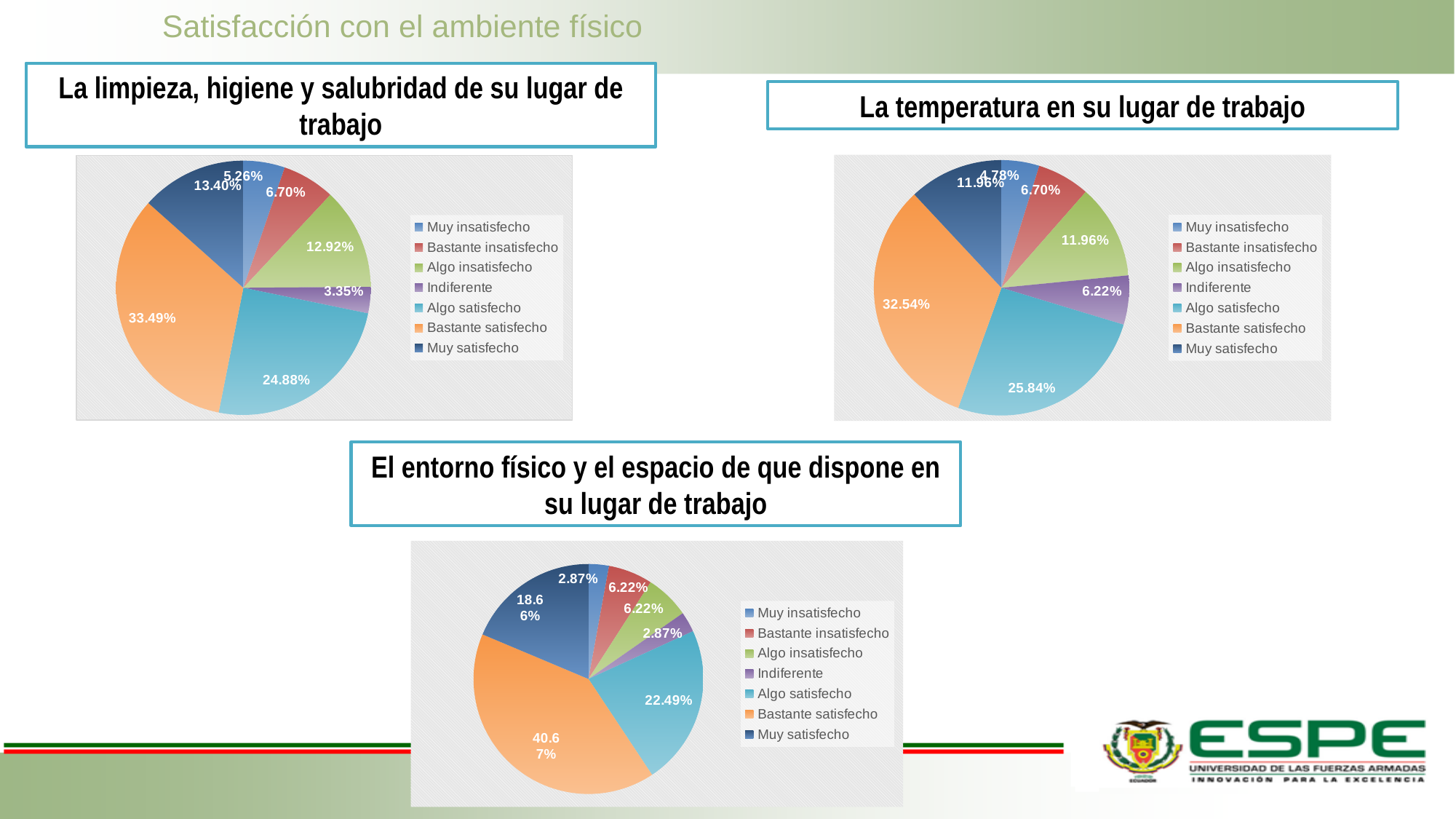
In the chart 'La temperatura en su lugar de trabajo', what percentage is shown for Algo satisfecho? 25.84% How many categories does the legend list in the chart 'El entorno físico y el espacio de que dispone en su lugar de trabajo'? 7 In the chart 'La limpieza, higiene y salubridad de su lugar de trabajo', what percentage is shown for Indiferente? 3.35% In the chart 'La limpieza, higiene y salubridad de su lugar de trabajo', which category has the smallest slice? Indiferente In the chart 'La temperatura en su lugar de trabajo', what percentage is shown for Muy insatisfecho? 4.78% What type of chart is used for 'La temperatura en su lugar de trabajo'? Pie chart In the chart 'La temperatura en su lugar de trabajo', which is larger: Indiferente or Bastante insatisfecho? Bastante insatisfecho In the chart 'La limpieza, higiene y salubridad de su lugar de trabajo', what percentage is shown for Bastante satisfecho? 33.49% In the chart 'La temperatura en su lugar de trabajo', which category has the largest slice? Bastante satisfecho In the chart 'El entorno físico y el espacio de que dispone en su lugar de trabajo', what percentage is shown for Algo satisfecho? 22.49% In the chart 'El entorno físico y el espacio de que dispone en su lugar de trabajo', what percentage is shown for Bastante satisfecho? 40.67% In the chart 'La limpieza, higiene y salubridad de su lugar de trabajo', what is the difference between Algo satisfecho and Muy satisfecho? 11.48%